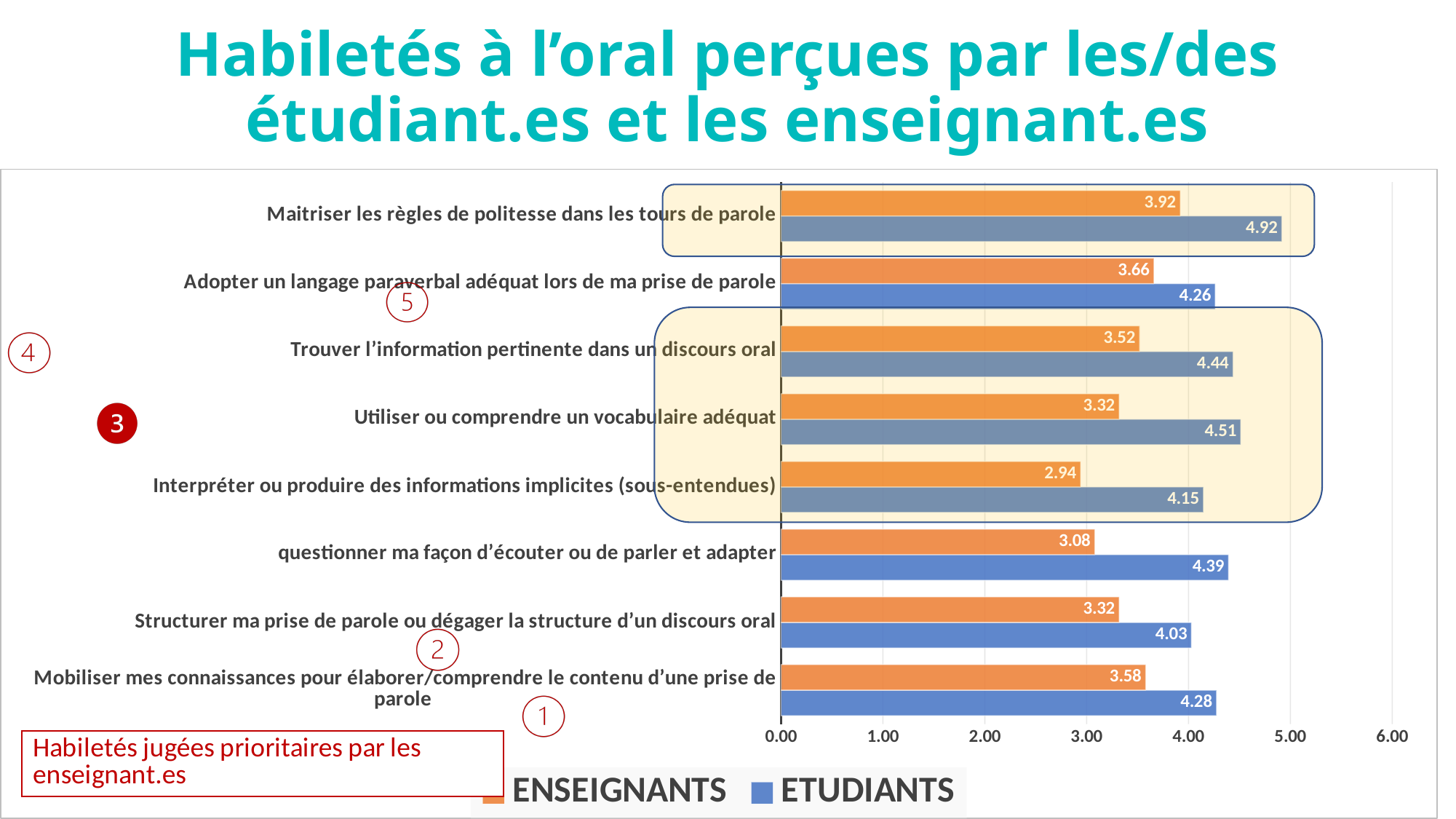
What type of chart is shown on the slide? bar chart For 'Utiliser ou comprendre un vocabulaire adéquat', which series has the larger value, ENSEIGNANTS or ETUDIANTS? ETUDIANTS How many categories (skills) are plotted in the chart? 8 Which colour represents the ENSEIGNANTS series in the chart? orange Which category has the lowest ETUDIANTS value? Structurer ma prise de parole ou dégager la structure d'un discours oral What is the difference between the ETUDIANTS and ENSEIGNANTS values for 'Interpréter ou produire des informations implicites (sous-entendues)'? 1.21 Which category has the highest ETUDIANTS value? Maitriser les règles de politesse dans les tours de parole What is the ENSEIGNANTS value for 'Interpréter ou produire des informations implicites (sous-entendues)'? 2.94 What is the ETUDIANTS value for 'Maitriser les règles de politesse dans les tours de parole'? 4.92 Which category has the lowest ENSEIGNANTS value? Interpréter ou produire des informations implicites (sous-entendues) How many series does the legend list? 2 What is the ENSEIGNANTS value for 'Adopter un langage paraverbal adéquat lors de ma prise de parole'? 3.66